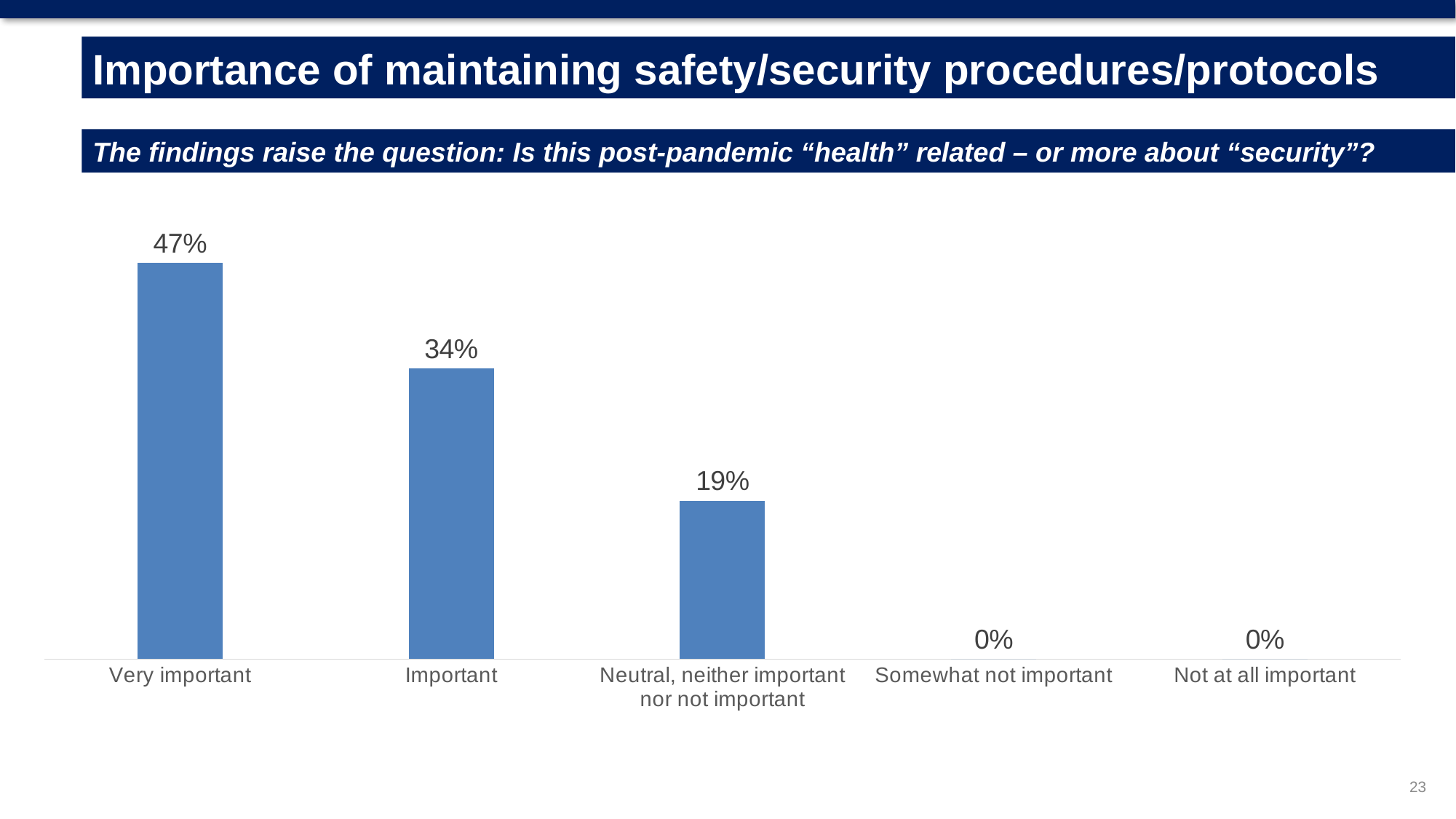
Which is larger, the value for Important or the value for Neutral, neither important nor not important? Important What is the combined value of Very important and Important? 81% How many categories are shown on the x axis? 5 What kind of chart is shown on the slide? Bar chart What is the value for Neutral, neither important nor not important? 19% What is the value for Important? 34% What is the difference between the values for Very important and Important? 13% Which category has the highest value? Very important What is the difference between the values for Important and Neutral, neither important nor not important? 15% Do the values rise or fall from left to right along the x axis? Fall What is the value for Very important? 47% What is the value for Somewhat not important? 0%